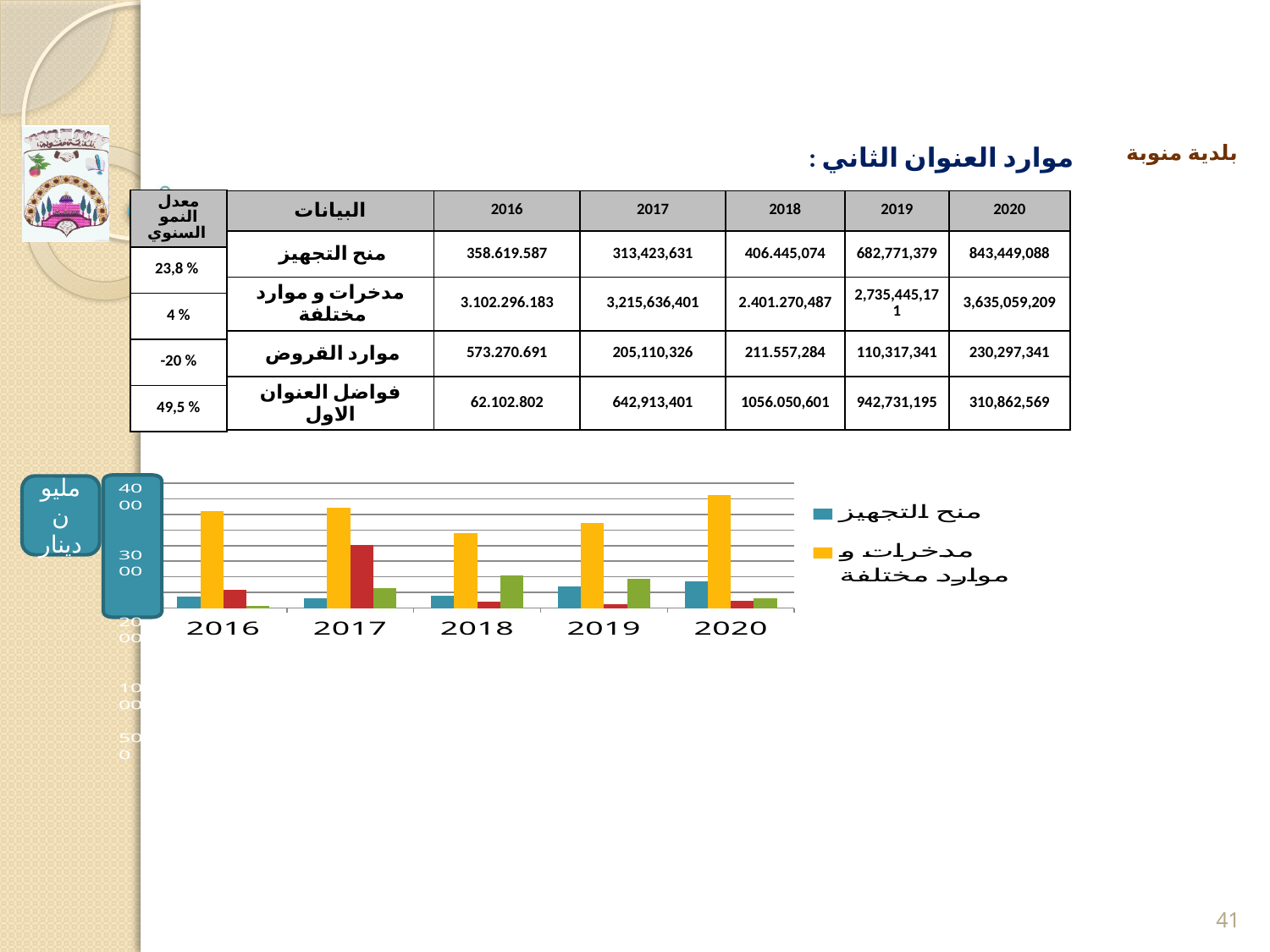
In 2020, which bar is taller: the blue bar or the green bar? the blue bar Which year has the shortest yellow (مدخرات و موارد مختلفة) bar in the chart? 2018 Is the yellow bar for 2020 greater or less than 4000? less Is the yellow bar for 2018 greater or less than 4000? less Which year has the tallest blue (منح التجهيز) bar in the chart? 2020 How many years are shown on the x axis of the bar chart? 5 What kind of chart is shown at the bottom of the slide? bar chart What colour is used for the series منح التجهيز in the chart legend? blue Which year has the tallest red bar in the chart? 2017 Which year has the tallest yellow (مدخرات و موارد مختلفة) bar in the chart? 2020 How many series does the chart legend list? 2 In 2017, which bar is taller: the blue bar or the red bar? the red bar